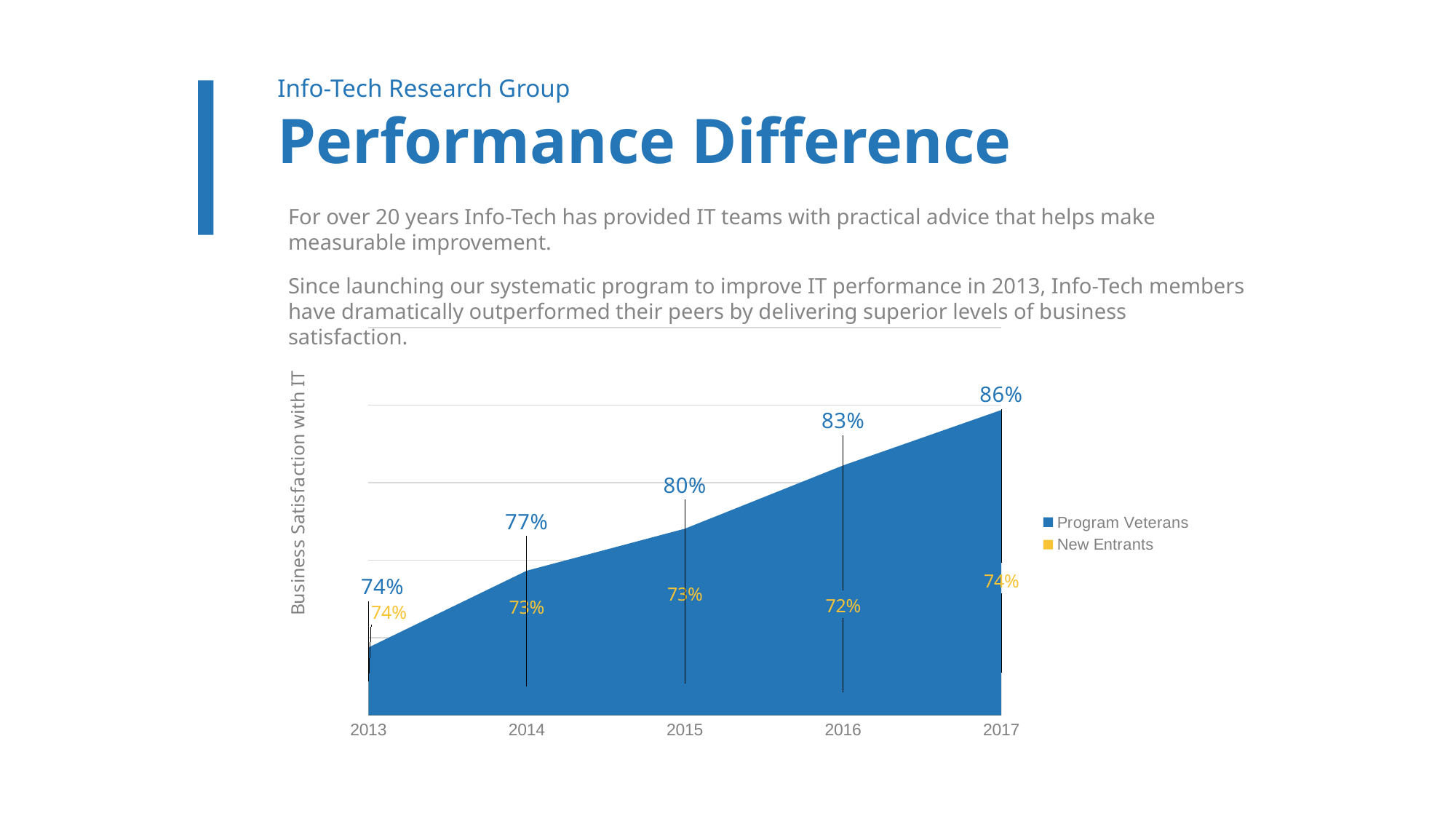
Which series has the larger value in 2016, Program Veterans or New Entrants? Program Veterans How many series does the legend list? 2 In which year is the New Entrants value lowest? 2016 What is the value for New Entrants in 2016? 72% What is the value for Program Veterans in 2015? 80% How many years are shown on the x axis? 5 What is the Business Satisfaction with IT value for Program Veterans in 2017? 86% Do the Program Veterans values rise or fall from 2013 to 2017? Rise What is the difference between the Program Veterans and New Entrants values in 2017? 12% In which year is the Program Veterans value highest? 2017 What is the value for New Entrants in 2014? 73% What kind of chart is shown on the slide? Area chart